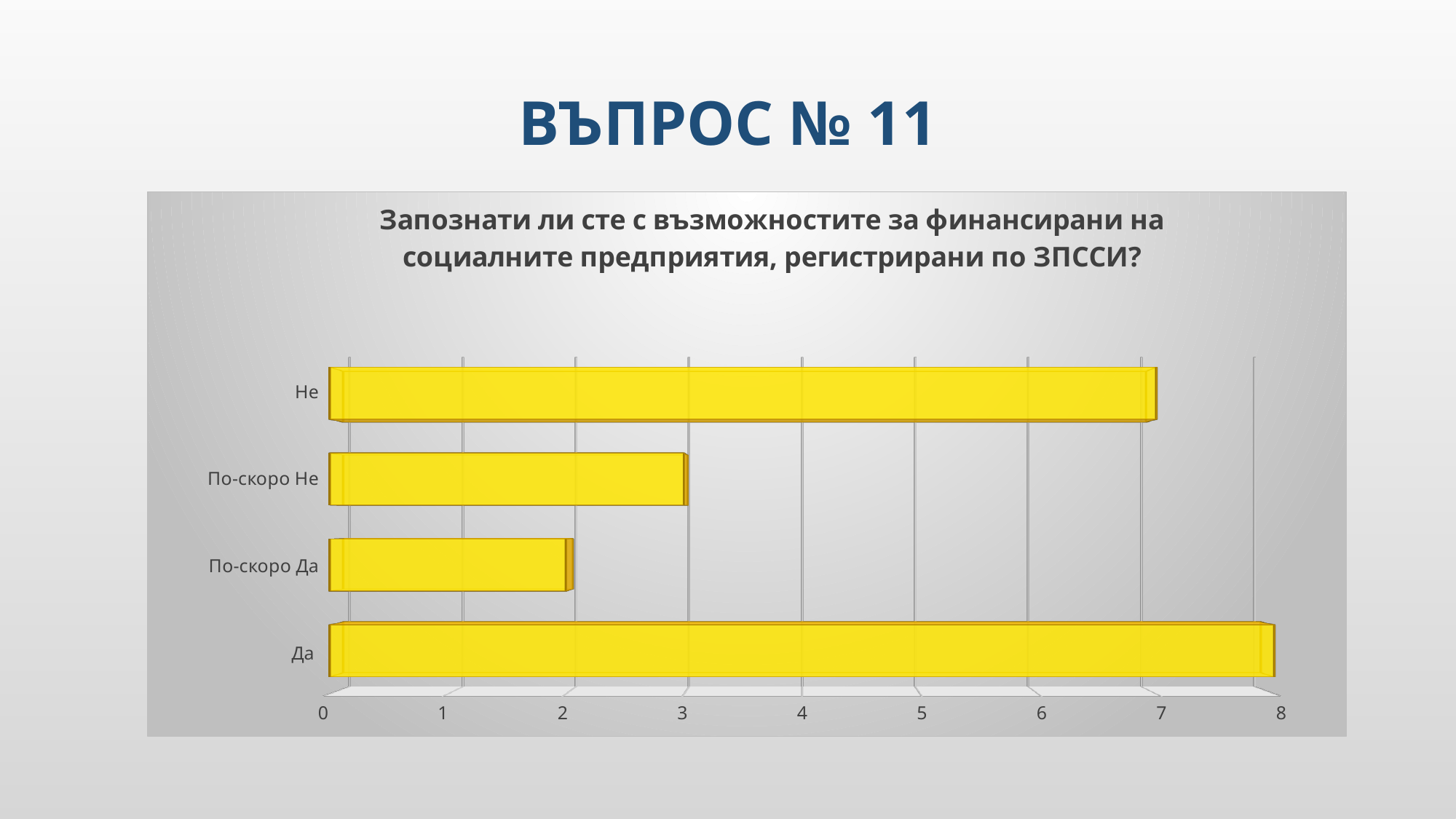
Is the value for "По-скоро Да" greater or less than 4? less What kind of chart is shown on the slide? bar chart Which category has the highest value? Да What is the value for "Да"? 8 Is the value for "Не" greater or less than 5? greater What is the value for "По-скоро Не"? 3 Which is larger, the value for "Не" or the value for "По-скоро Не"? Не How many categories are shown in the chart? 4 What is the value for "Не"? 7 What is the title of the chart? Запознати ли сте с възможностите за финансирани на социалните предприятия, регистрирани по ЗПССИ? Which category has the lowest value? По-скоро Да What is the value for "По-скоро Да"? 2